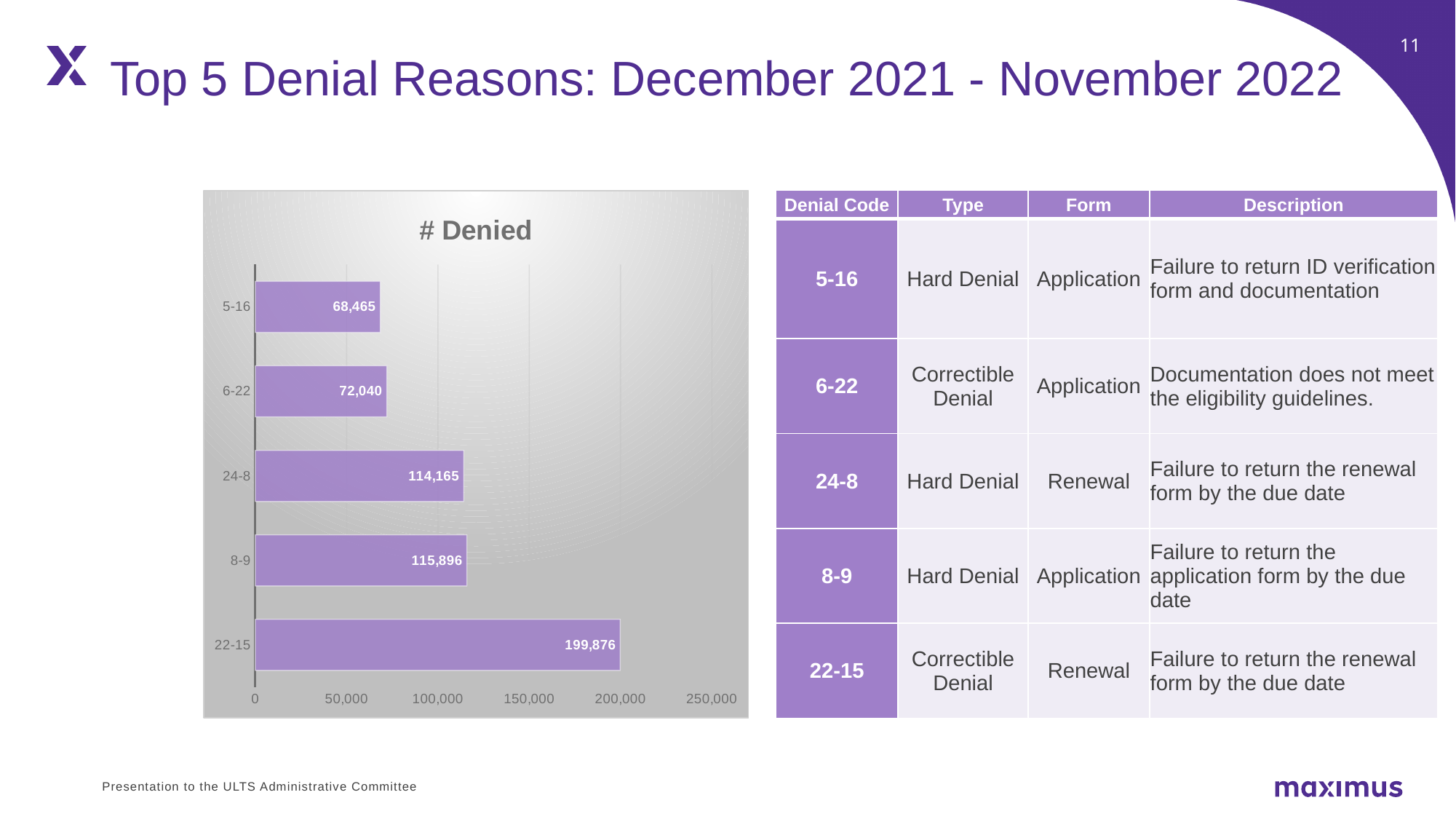
What is the number denied for denial code 22-15? 199,876 Is the value for 22-15 greater or less than 150,000? greater Which has a larger number denied, 24-8 or 6-22? 24-8 What is the number denied for denial code 24-8? 114,165 Which denial code has the lowest number denied? 5-16 What is the difference between the number denied for 22-15 and for 8-9? 83,980 What kind of chart is shown on the slide? bar chart What is the number denied for denial code 5-16? 68,465 What is the difference between the number denied for 6-22 and for 5-16? 3,575 Which denial code has the highest number denied? 22-15 What is the title of the chart? # Denied How many denial codes are shown in the chart? 5